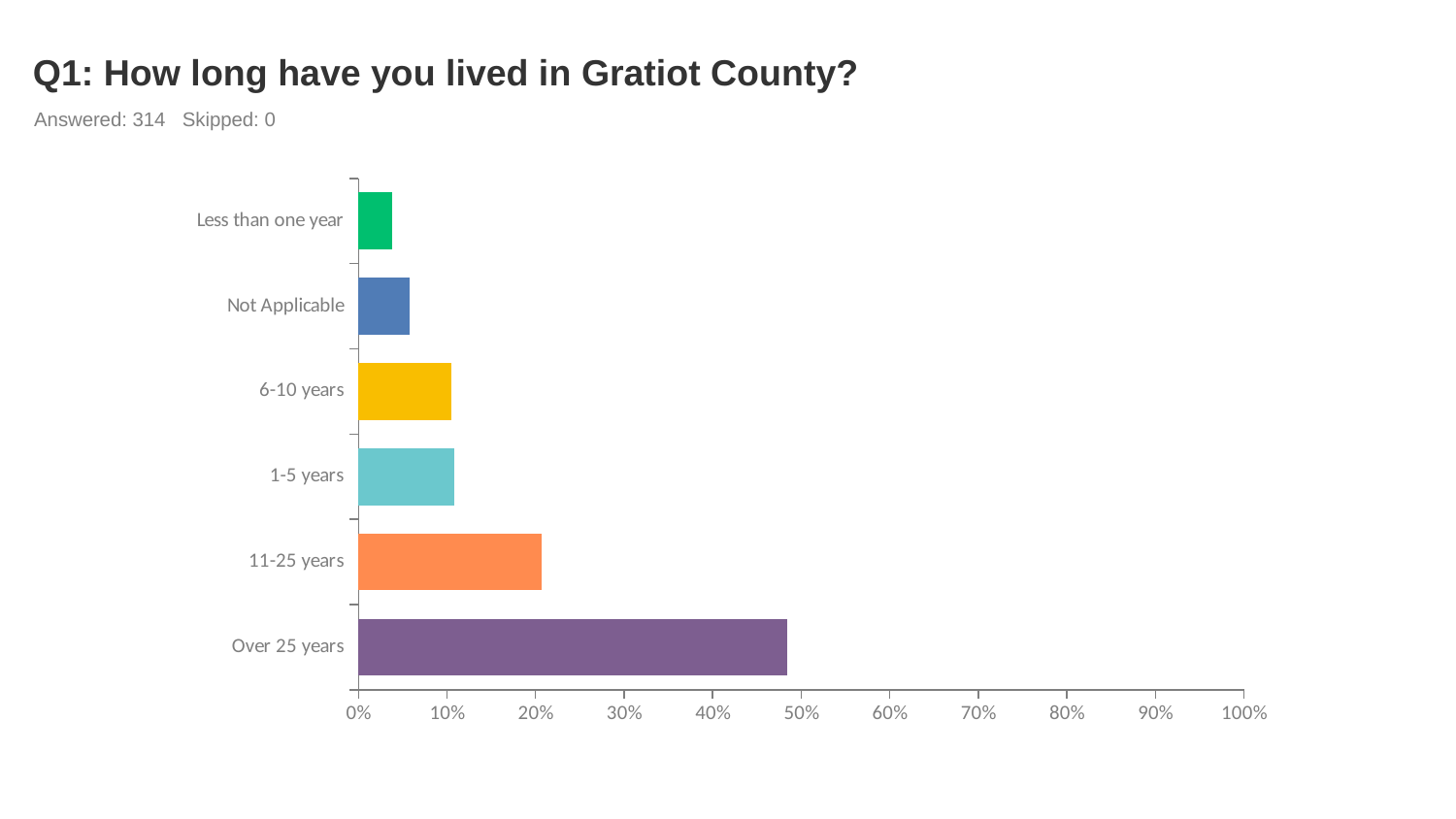
What is the title of the chart? Q1: How long have you lived in Gratiot County? Is the value for Not Applicable greater or less than 10%? less Which is larger, the value for Over 25 years or the value for 11-25 years? Over 25 years What kind of chart is shown on the slide? bar chart Which is larger, the value for 11-25 years or the value for 1-5 years? 11-25 years How many categories are shown in the chart? 6 Which category has the lowest value? Less than one year Is the value for Over 25 years greater or less than 40%? greater Is the value for Less than one year greater or less than 10%? less Which category has the highest value? Over 25 years